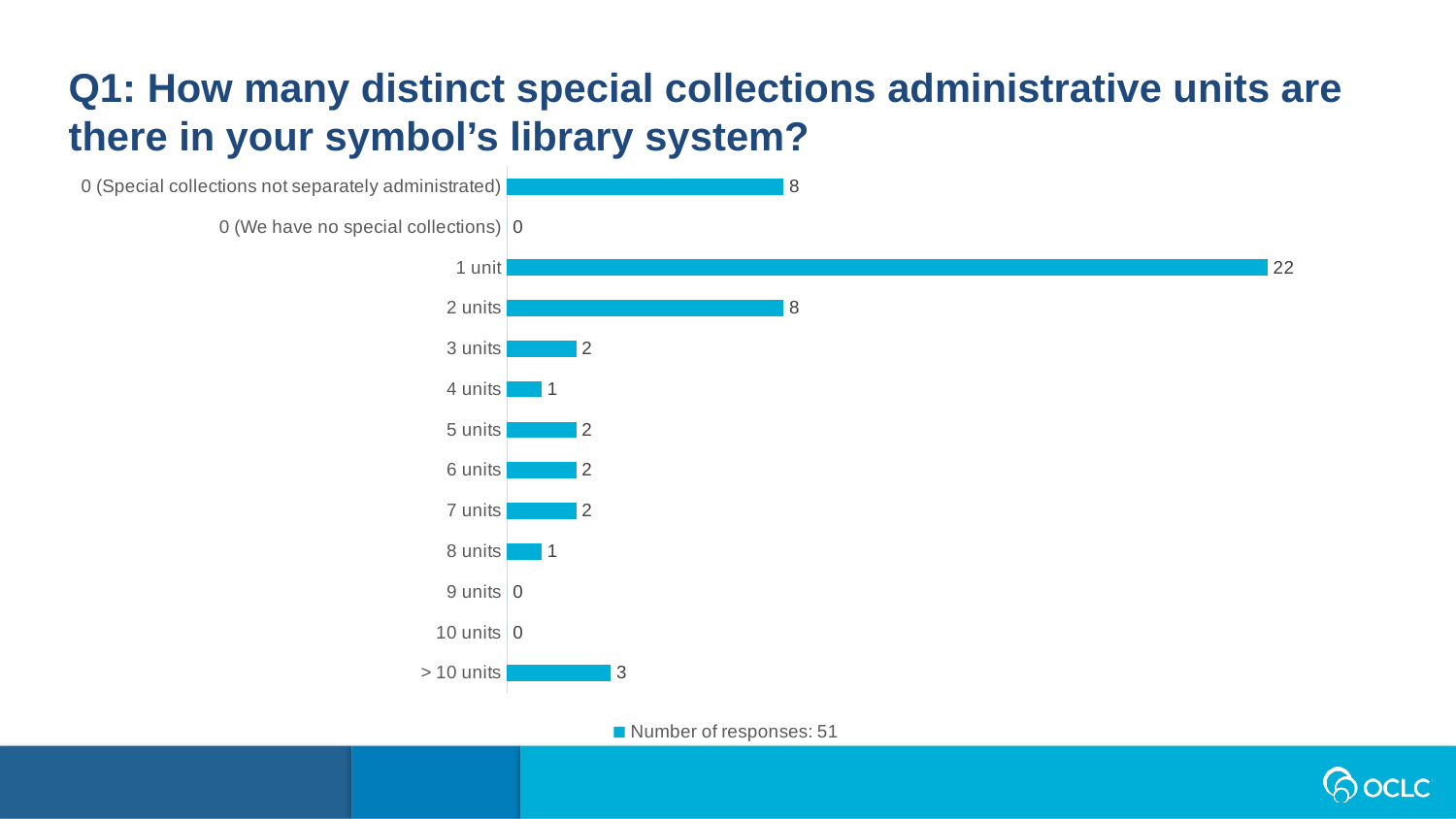
Which category has the highest value? 1 unit How many categories have a value of 0? 3 What is the legend entry for the series? Number of responses: 51 What is the value for "0 (Special collections not separately administrated)"? 8 What is the value for "1 unit"? 22 What is the value for "> 10 units"? 3 How many categories are shown on the chart? 13 What is the value for "4 units"? 1 How many series does the legend list? 1 Which is larger, the value for "3 units" or the value for "> 10 units"? > 10 units What kind of chart is shown on the slide? Bar chart What is the difference between the values for "1 unit" and "2 units"? 14